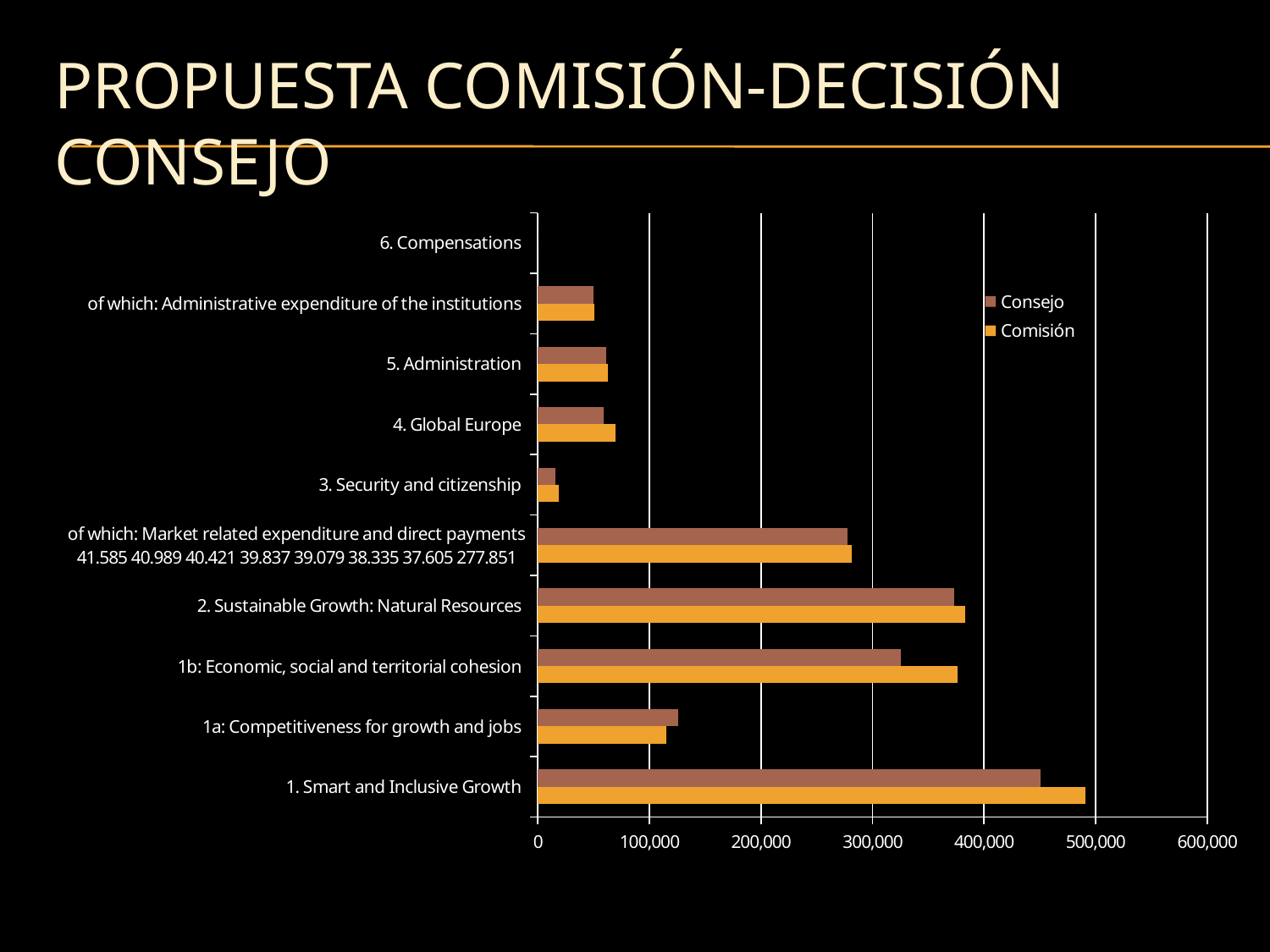
For 1b: Economic, social and territorial cohesion, which series has the larger value, Consejo or Comisión? Comisión What are the two series named in the legend? Consejo and Comisión Is the Comisión value for 1. Smart and Inclusive Growth greater or less than 400,000? greater Which category has the highest Consejo value? 1. Smart and Inclusive Growth How many series does the legend list? 2 How many categories are listed on the vertical axis of the chart? 10 For 1. Smart and Inclusive Growth, which series has the larger value, Consejo or Comisión? Comisión Which category has the highest Comisión value? 1. Smart and Inclusive Growth What kind of chart is shown on the slide? Bar chart Is the Comisión value for 2. Sustainable Growth: Natural Resources greater or less than 300,000? greater Is the Consejo value for 1b: Economic, social and territorial cohesion greater or less than 300,000? greater